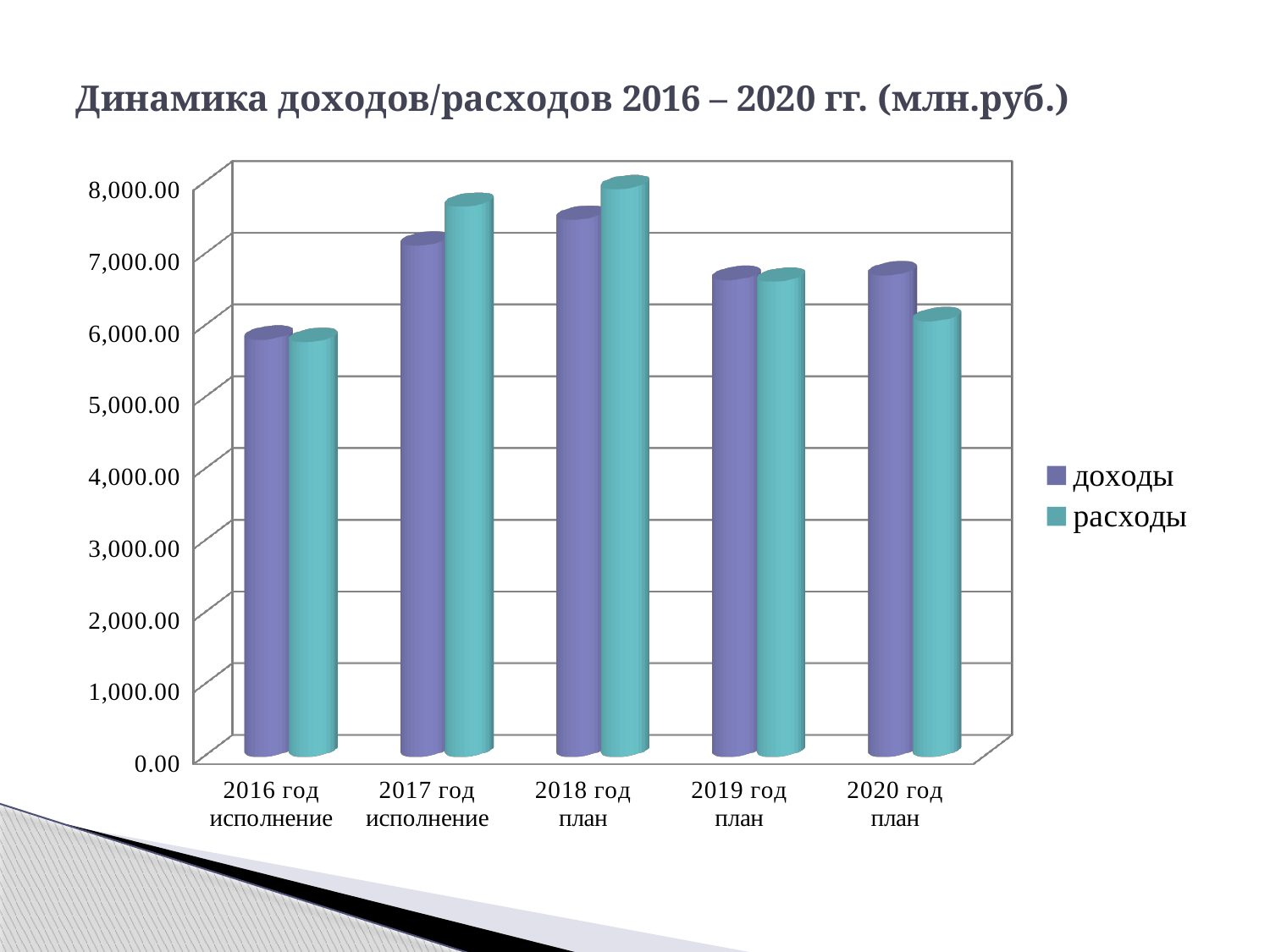
What is the title of the chart? Динамика доходов/расходов 2016 – 2020 гг. (млн.руб.) Which category has the highest value for расходы? 2018 год план For 2017 год исполнение, which is larger: доходы or расходы? расходы What kind of chart is shown on the slide? bar chart Is the value for расходы in 2018 год план greater or less than 7,000.00? greater Which category has the highest value for доходы? 2018 год план Do the values for доходы rise or fall from 2016 год исполнение to 2018 год план? rise For 2020 год план, which is larger: доходы or расходы? доходы How many series does the legend list? 2 How many year categories are shown on the x axis? 5 Is the value for доходы in 2016 год исполнение greater or less than 6,000.00? less Which category has the lowest value for доходы? 2016 год исполнение